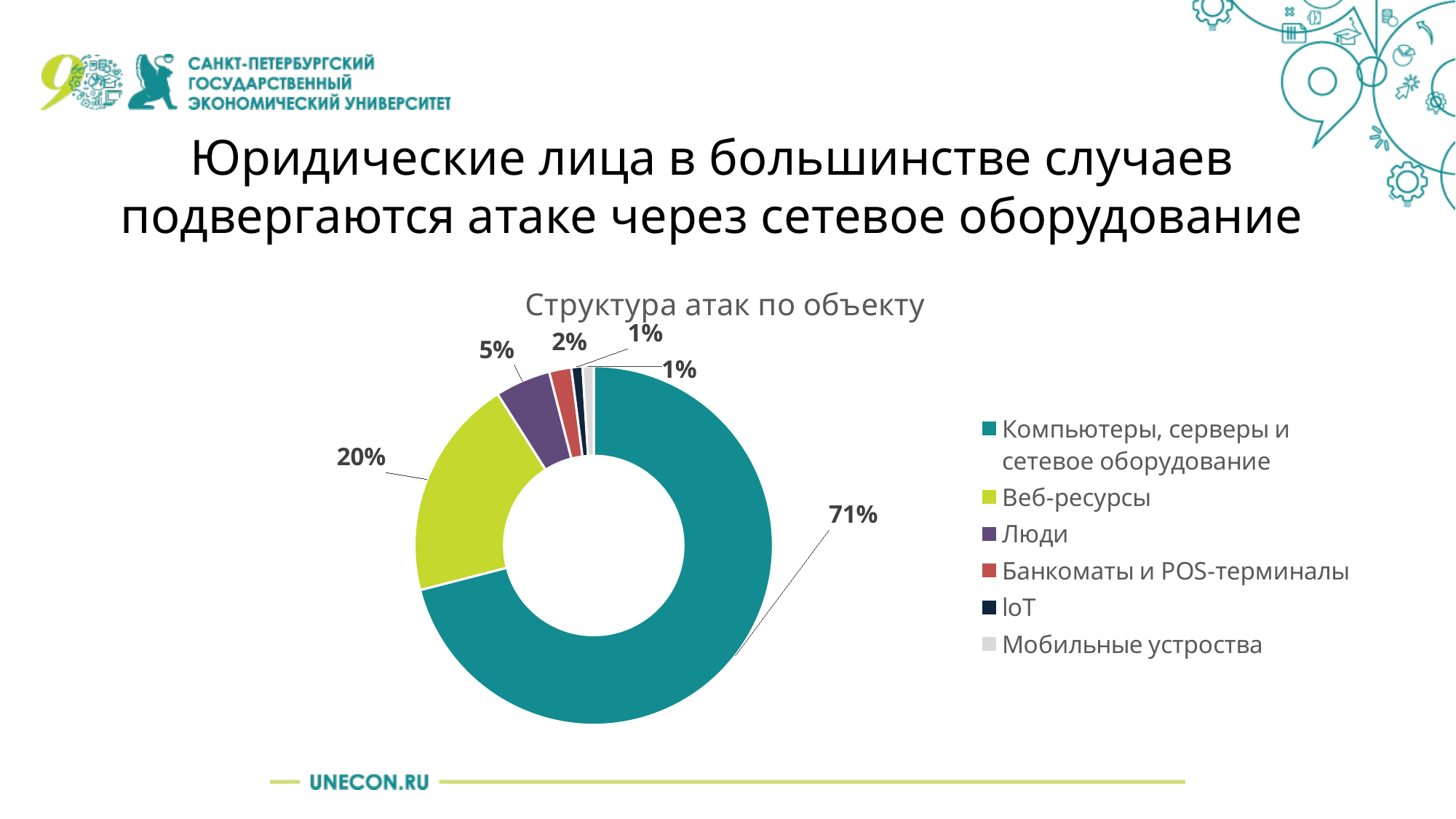
Which category has the largest share of attacks? Компьютеры, серверы и сетевое оборудование What share of attacks is attributed to Веб-ресурсы? 20% How many categories does the chart show? 6 What share of attacks is attributed to Банкоматы и POS-терминалы? 2% What share of attacks is attributed to IoT? 1% What is the difference in percentage points between the share for Компьютеры, серверы и сетевое оборудование and the share for Веб-ресурсы? 51 What is the combined share of Люди and Веб-ресурсы? 25% What is the title of the chart? Структура атак по объекту What share of attacks is attributed to Люди? 5% What share of attacks is attributed to Компьютеры, серверы и сетевое оборудование? 71% Which has a larger share: Люди or Банкоматы и POS-терминалы? Люди What type of chart is shown on the slide? Doughnut (pie) chart